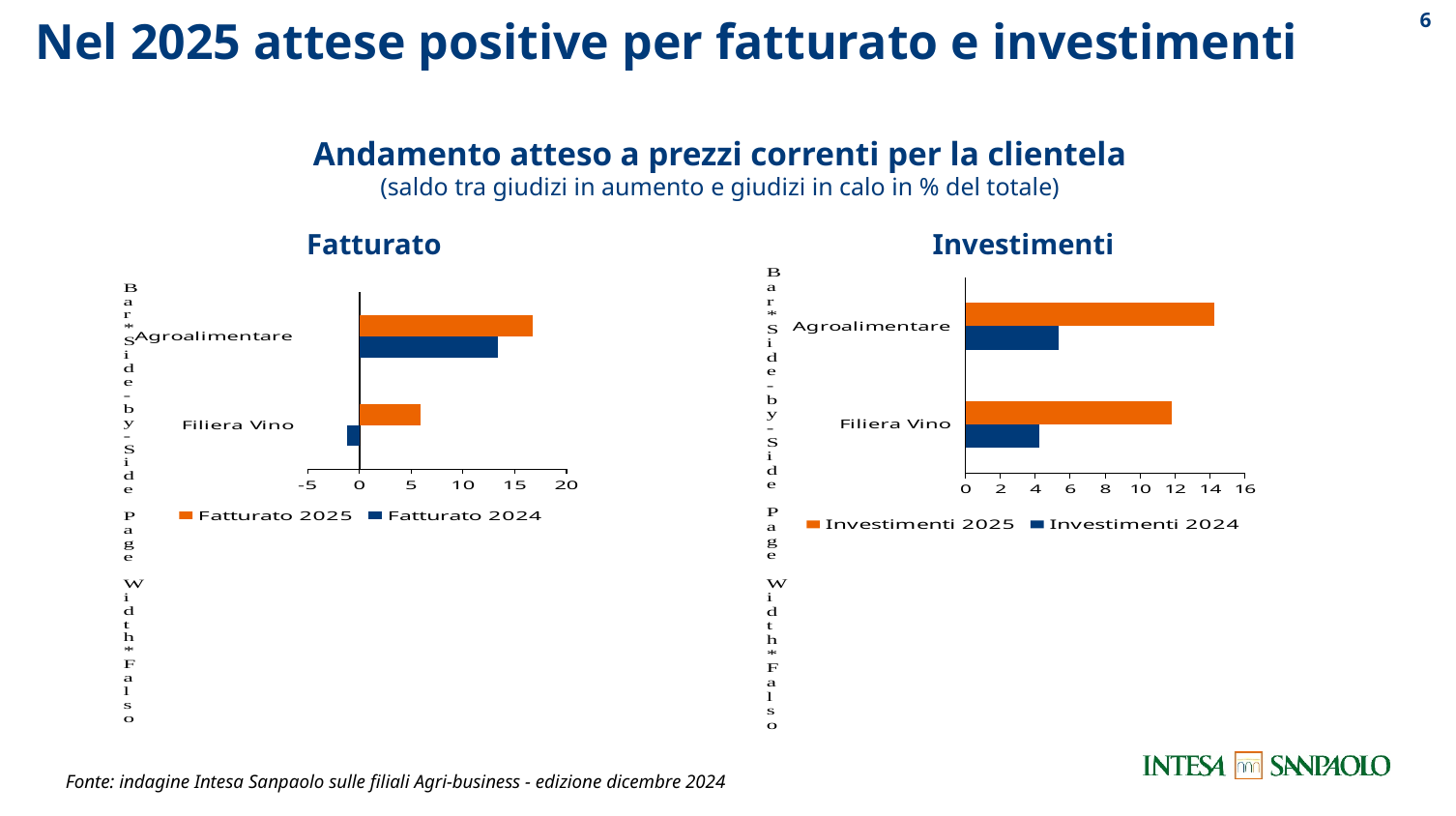
In the Fatturato chart, is the value for Agroalimentare in Fatturato 2025 greater or less than 15? greater How many categories are shown on the Fatturato chart? 2 In the Fatturato chart, is the value for Filiera Vino in Fatturato 2025 greater or less than 10? less How many series does the legend of the Investimenti chart list? 2 What kind of chart is the Fatturato chart? bar chart In the Investimenti chart, which is larger for Filiera Vino: Investimenti 2025 or Investimenti 2024? Investimenti 2025 In the Fatturato chart, is the value for Filiera Vino in Fatturato 2024 greater or less than 0? less In the Investimenti chart, which category has the highest value for Investimenti 2025? Agroalimentare What colour are the Fatturato 2024 bars in the Fatturato chart? dark blue In the Fatturato chart, which is larger for Agroalimentare: Fatturato 2025 or Fatturato 2024? Fatturato 2025